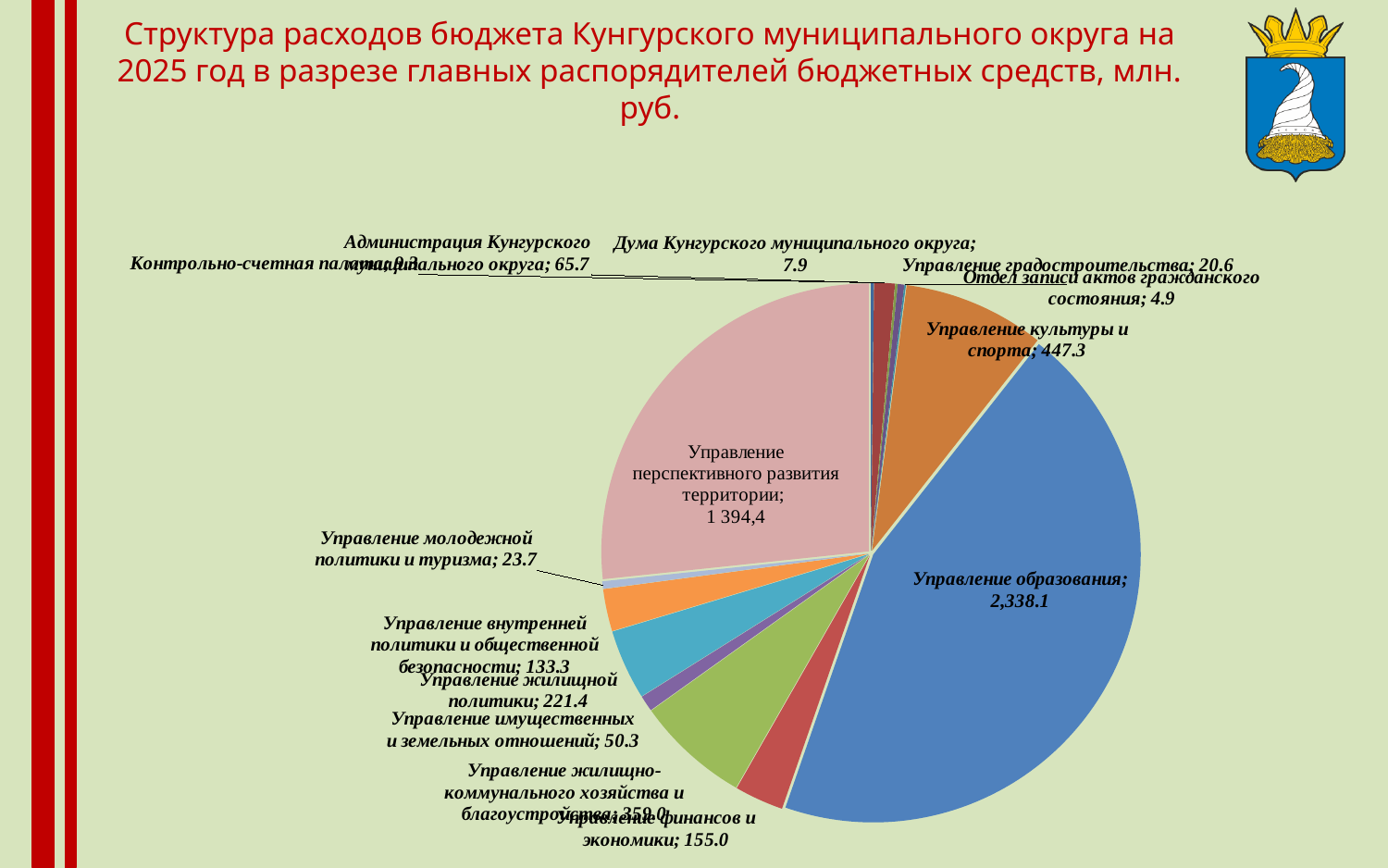
What is the difference between Управление культуры и спорта (447.3) and Управление жилищной политики (221.4)? 225.9 What is the difference between Администрация Кунгурского муниципального округа (65.7) and Дума Кунгурского муниципального округа (7.9)? 57.8 Which is larger: Управление культуры и спорта or Управление жилищной политики? Управление культуры и спорта Which category has the largest slice of the pie? Управление образования What is the value for Управление культуры и спорта? 447.3 What is the value for Дума Кунгурского муниципального округа? 7.9 What is the value for Управление внутренней политики и общественной безопасности? 133.3 What kind of chart is shown on the slide? pie chart What is the value for Управление образования? 2,338.1 In what units are the values in the chart expressed, according to the slide title? млн. руб. What is the value for Управление перспективного развития территории? 1 394,4 What is the value for Управление жилищной политики? 221.4